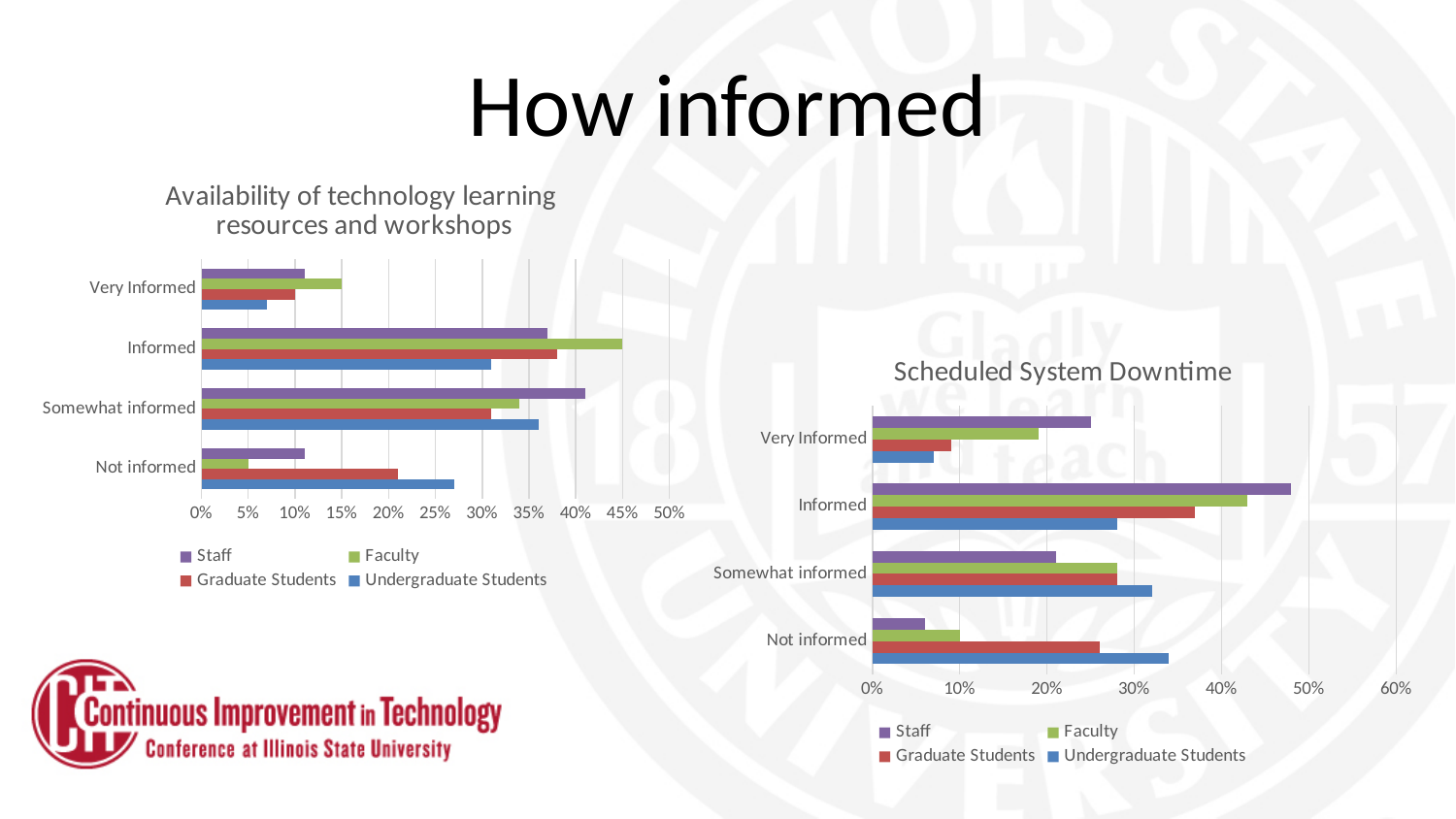
In the 'Availability of technology learning resources and workshops' chart, is the Undergraduate Students value for Not informed greater or less than 20%? greater What is the title of the chart on the right side of the slide? Scheduled System Downtime How many series does the legend of the 'Scheduled System Downtime' chart list? 4 In the 'Scheduled System Downtime' chart, for Very Informed, which is larger: Staff or Undergraduate Students? Staff What kind of chart is the 'Availability of technology learning resources and workshops' chart? bar chart In the 'Availability of technology learning resources and workshops' chart, which group has the highest value for Informed? Faculty How many categories are shown on the 'Availability of technology learning resources and workshops' chart? 4 In the 'Availability of technology learning resources and workshops' chart, for Not informed, which is larger: Graduate Students or Faculty? Graduate Students How many series does the legend of the 'Availability of technology learning resources and workshops' chart list? 4 In the 'Availability of technology learning resources and workshops' chart, is the Faculty value for Informed greater or less than 40%? greater In the 'Scheduled System Downtime' chart, which group has the lowest value for Not informed? Staff In the 'Scheduled System Downtime' chart, is the Staff value for Informed greater or less than 40%? greater